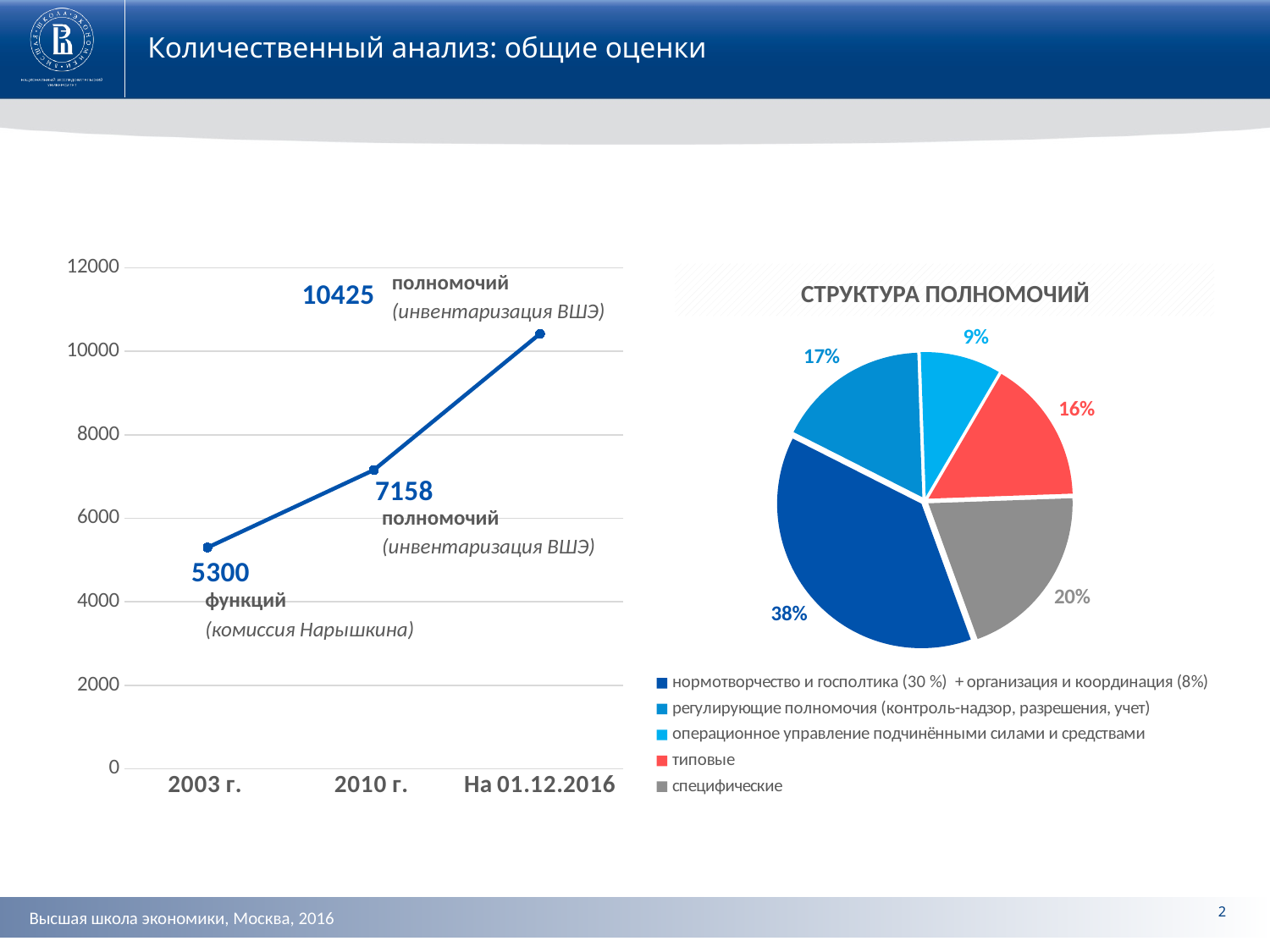
What kind of chart is the chart on the left? line chart In the line chart on the left, what is the value for 2003 г.? 5300 In the line chart on the left, do the values rise or fall from 2003 г. to На 01.12.2016? rise In the chart titled СТРУКТУРА ПОЛНОМОЧИЙ, which slice is the smallest? операционное управление подчинёнными силами и средствами In the chart titled СТРУКТУРА ПОЛНОМОЧИЙ, what share does the slice for типовые have? 16% In the chart titled СТРУКТУРА ПОЛНОМОЧИЙ, which is larger: специфические or регулирующие полномочия (контроль-надзор, разрешения, учет)? специфические In the line chart on the left, how many data points are plotted? 3 In the line chart on the left, what is the difference between the values for На 01.12.2016 and 2003 г.? 5125 How many entries does the legend of the chart titled СТРУКТУРА ПОЛНОМОЧИЙ list? 5 In the line chart on the left, which point has the highest value? На 01.12.2016 In the line chart on the left, what is the value for 2010 г.? 7158 In the line chart on the left, what is the value for На 01.12.2016? 10425